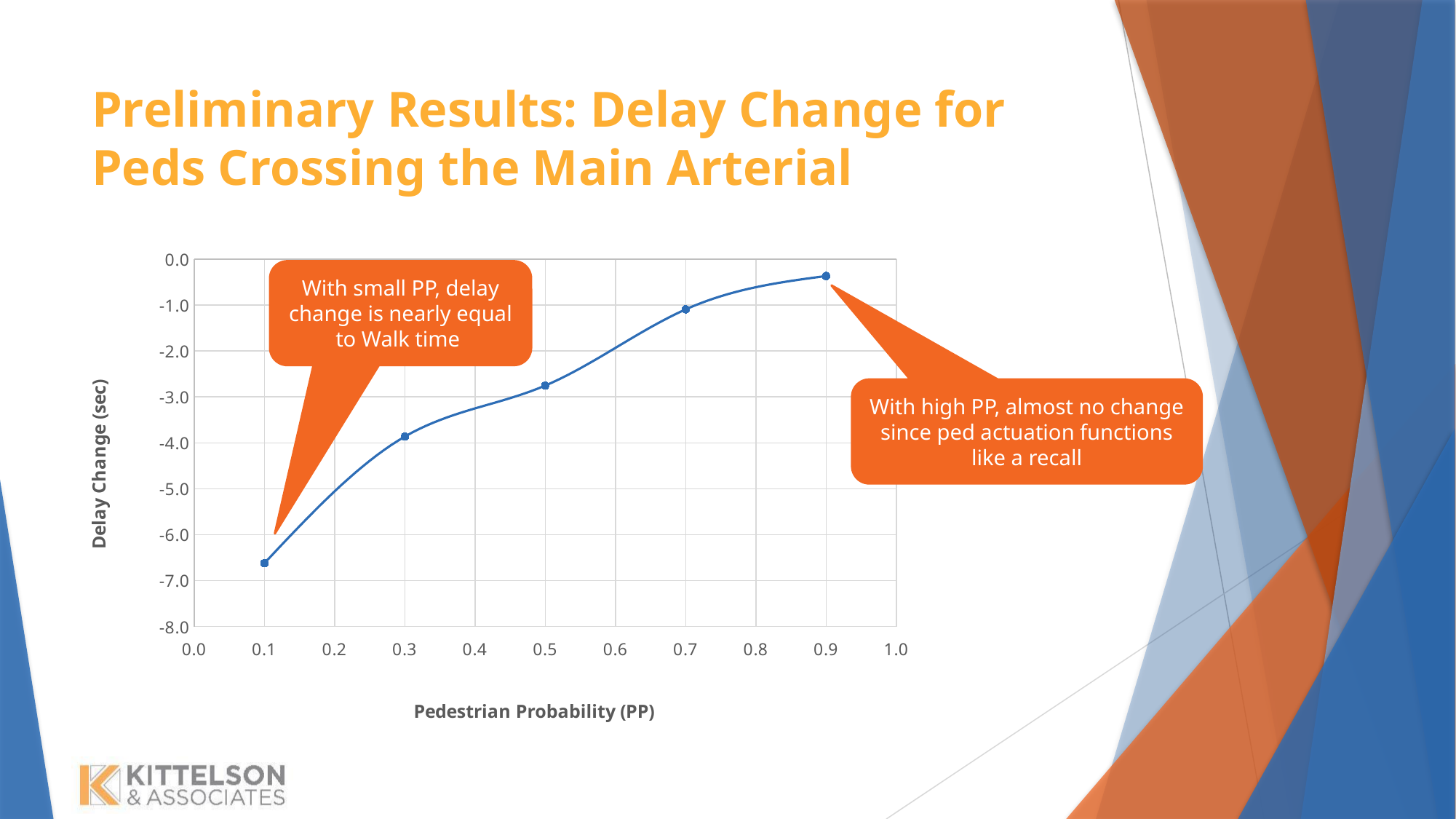
Is the delay change at PP = 0.1 greater or less than -6.0? less Is the delay change at PP = 0.3 greater or less than -3.0? less Is the delay change at PP = 0.9 greater or less than -1.0? greater At which Pedestrian Probability (PP) is the delay change highest (closest to zero)? 0.9 How many data points are plotted on the chart? 5 Which has the larger (less negative) delay change: PP = 0.3 or PP = 0.7? 0.7 What is the label of the horizontal axis? Pedestrian Probability (PP) What kind of chart is shown on the slide? line chart What is the label of the vertical axis? Delay Change (sec) At which Pedestrian Probability (PP) is the delay change lowest (most negative)? 0.1 Does the delay change rise or fall as Pedestrian Probability increases from 0.1 to 0.9? rise